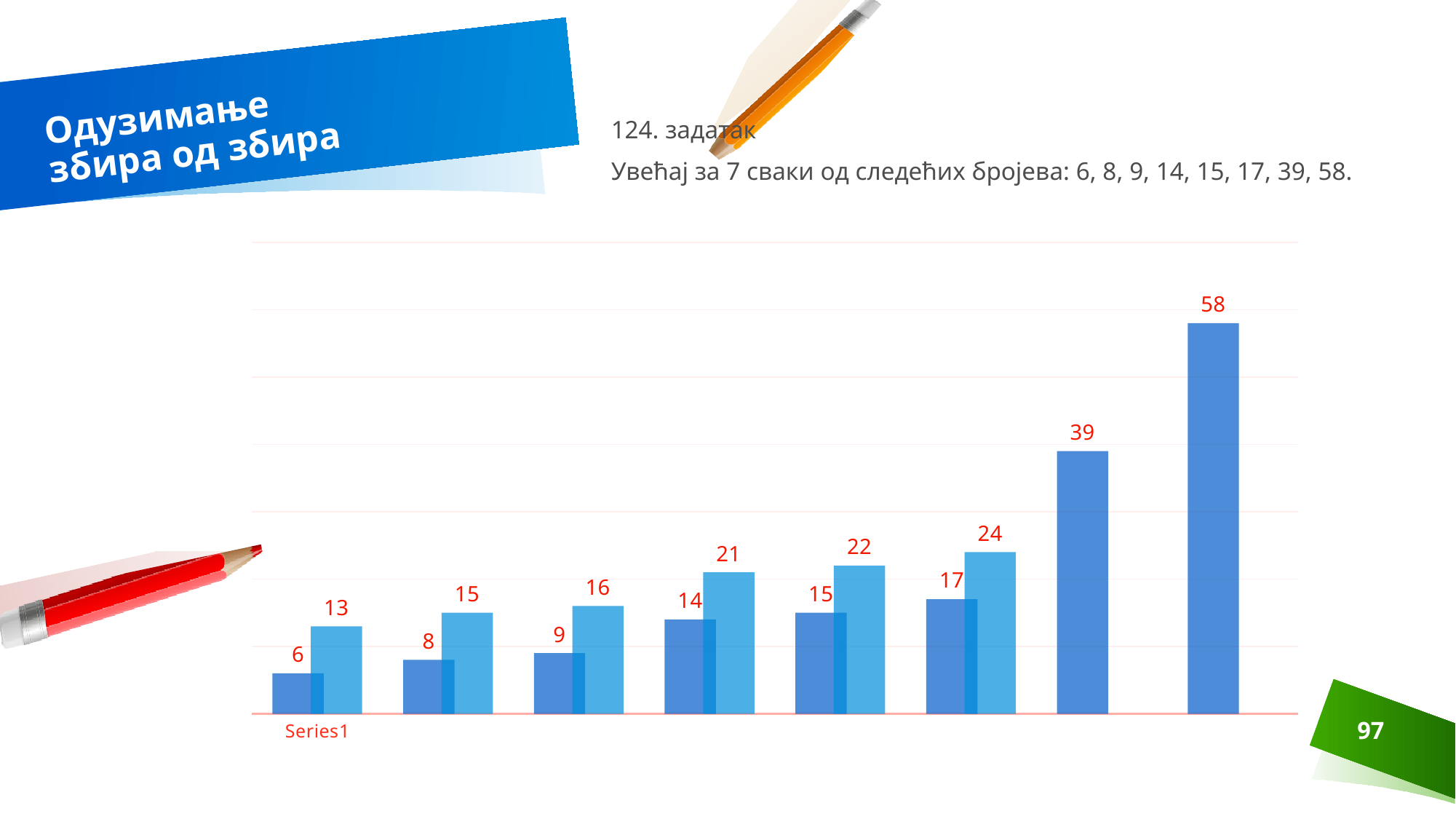
What is the difference between the two tallest dark blue bars, labelled 58 and 39? 19 How many light blue bars are plotted in the chart? 6 What is the value of the light blue bar in the first group on the left? 13 How many dark blue bars are plotted in the chart? 8 What kind of chart is shown on the slide? bar chart Which is larger: the dark blue bar labelled 39 or the light blue bar labelled 24? the dark blue bar labelled 39 What is the highest value labelled on any bar in the chart? 58 Do the values of the dark blue bars rise or fall from left to right? rise What is the value of the light blue bar in the group whose dark blue bar is labelled 14? 21 What is the lowest value labelled on any bar in the chart? 6 What is the only category label printed below the horizontal axis? Series1 In the sixth group from the left, what is the difference between the light blue bar (24) and the dark blue bar (17)? 7